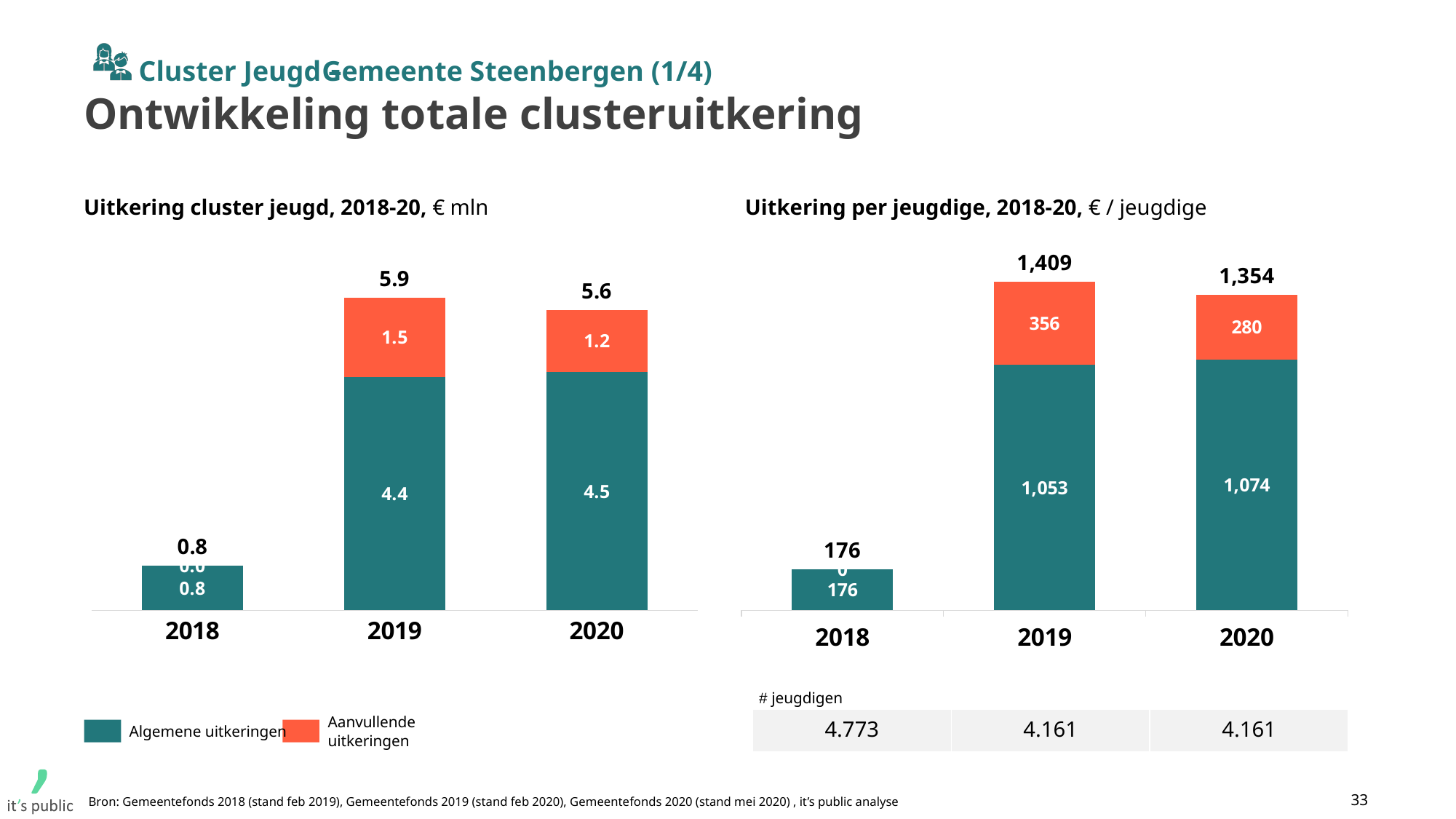
In the left chart 'Uitkering cluster jeugd, 2018-20', which year has the lowest total? 2018 In the right chart 'Uitkering per jeugdige, 2018-20', what is the value of Aanvullende uitkeringen for 2020? 280 In the right chart 'Uitkering per jeugdige, 2018-20', which year has the highest total? 2019 In the left chart 'Uitkering cluster jeugd, 2018-20', what is the total value for 2019? 5.9 In the right chart 'Uitkering per jeugdige, 2018-20', is the Algemene uitkeringen value larger in 2019 or 2020? 2020 In the right chart 'Uitkering per jeugdige, 2018-20', what is the total value for 2019? 1,409 In the right chart 'Uitkering per jeugdige, 2018-20', what is the value of Algemene uitkeringen for 2018? 176 In the left chart 'Uitkering cluster jeugd, 2018-20', what is the difference between the totals for 2019 and 2020? 0.3 In the left chart 'Uitkering cluster jeugd, 2018-20', what is the value of Algemene uitkeringen for 2020? 4.5 What kind of chart is the left chart 'Uitkering cluster jeugd, 2018-20'? Stacked bar chart How many series does the legend list? 2 In the left chart 'Uitkering cluster jeugd, 2018-20', what is the value of Aanvullende uitkeringen for 2019? 1.5